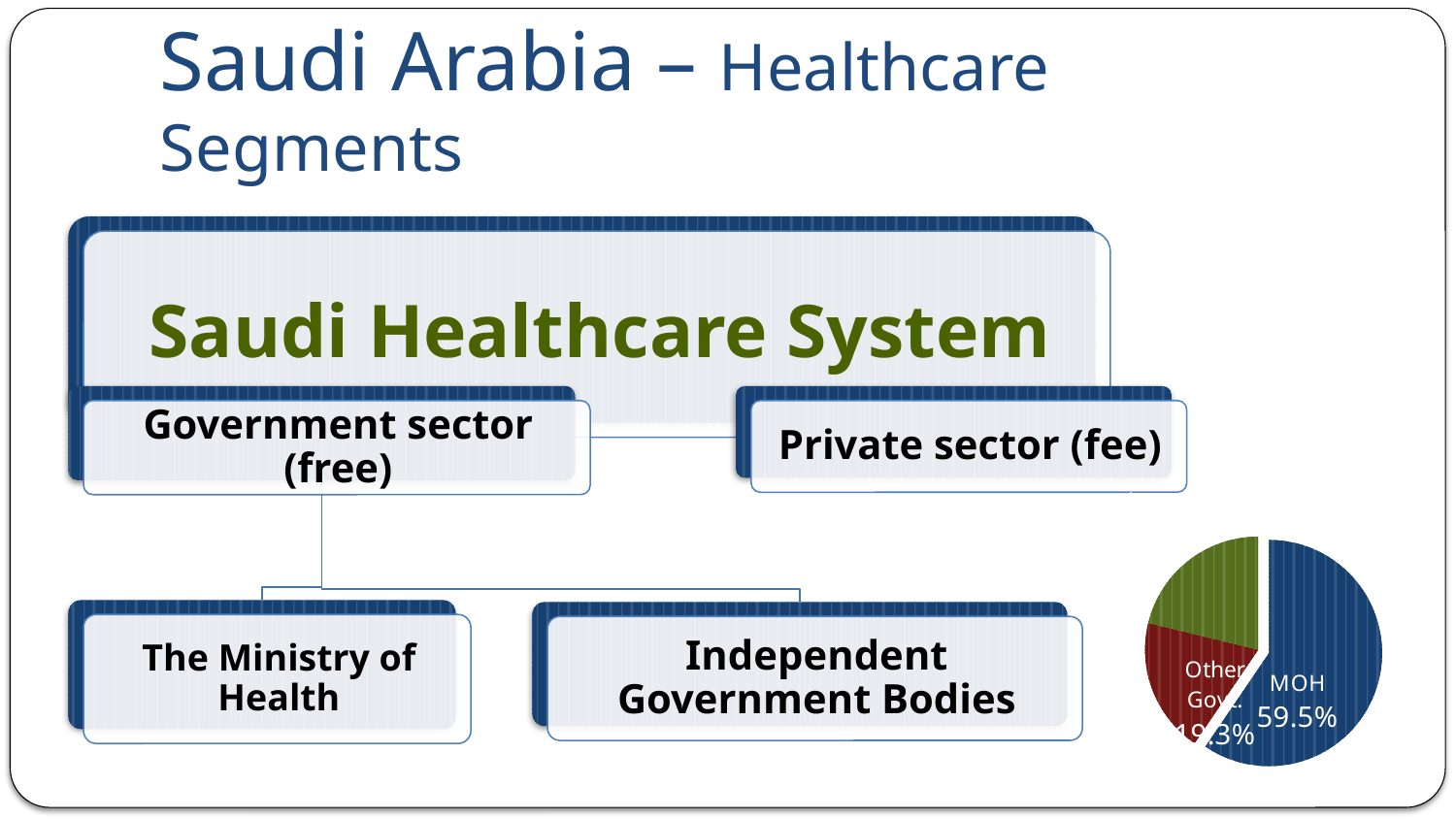
What colour is the MOH slice in the pie chart? blue In the pie chart, what share is labelled for MOH? 59.5% Which slice of the pie chart is the largest? MOH In the pie chart, which is larger: the MOH slice or the Other Govt. slice? MOH What kind of chart is shown at the bottom right of the slide? pie chart How many slices does the pie chart have? 3 Does the MOH slice account for more or less than half of the pie chart? more